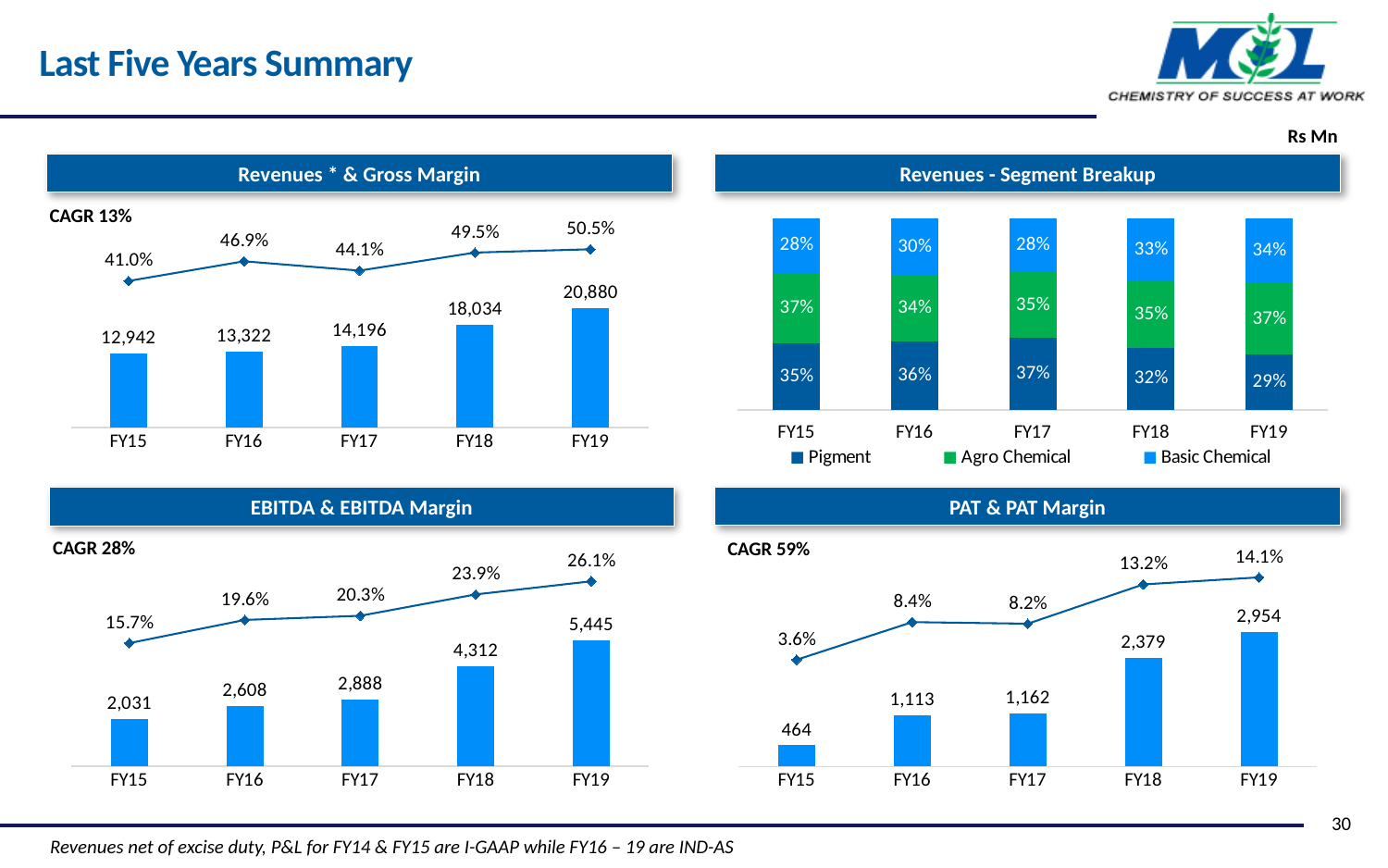
In the 'Revenues * & Gross Margin' chart, what is the difference between the FY19 and FY15 revenue values? 7,938 In the 'PAT & PAT Margin' chart, which year has the lowest PAT? FY15 How many series does the legend of the 'Revenues - Segment Breakup' chart list? 3 In the 'Revenues - Segment Breakup' chart, what is the Basic Chemical share in FY19? 34% In the 'PAT & PAT Margin' chart, which is larger, the PAT margin for FY16 or FY17? FY16 In the 'Revenues * & Gross Margin' chart, what is the revenue value for FY18? 18,034 In the 'PAT & PAT Margin' chart, what is the difference between the PAT values for FY19 and FY18? 575 In the 'Revenues - Segment Breakup' chart, what is the Pigment share in FY17? 37% In the 'EBITDA & EBITDA Margin' chart, which year has the highest EBITDA? FY19 In the 'EBITDA & EBITDA Margin' chart, what is the EBITDA margin for FY16? 19.6% In the 'Revenues * & Gross Margin' chart, what is the gross margin for FY17? 44.1% How many years are shown on the x axis of the 'EBITDA & EBITDA Margin' chart? 5